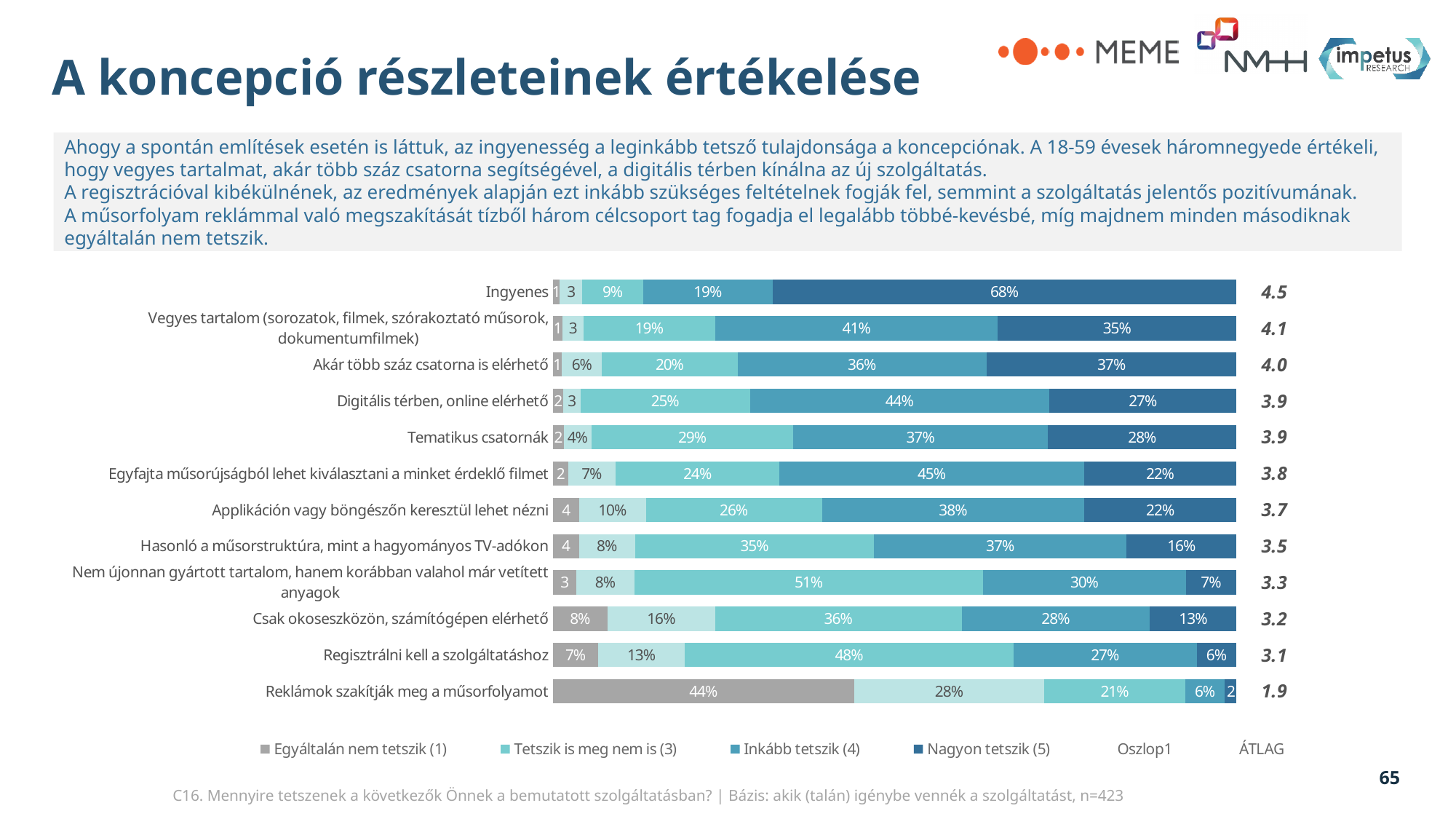
What is the "Egyáltalán nem tetszik (1)" share for "Reklámok szakítják meg a műsorfolyamot"? 44% What is the ÁTLAG value for "Regisztrálni kell a szolgáltatáshoz"? 3.1 What percentage of respondents answered "Nagyon tetszik (5)" for "Ingyenes"? 68% What is the difference in the "Nagyon tetszik (5)" share between "Ingyenes" (68%) and "Vegyes tartalom" (35%)? 33 percentage points Which has a larger "Inkább tetszik (4)" share: "Egyfajta műsorújságból lehet kiválasztani a minket érdeklő filmet" or "Tematikus csatornák"? Egyfajta műsorújságból lehet kiválasztani a minket érdeklő filmet What is the "Tetszik is meg nem is (3)" share for "Nem újonnan gyártott tartalom, hanem korábban valahol már vetített anyagok"? 51% How many items (categories) are shown in the chart? 12 How many entries does the chart legend list? 6 Which item has the highest ÁTLAG value? Ingyenes Do the ÁTLAG values rise or fall going from the top item to the bottom item of the chart? Fall Which item has the lowest ÁTLAG value? Reklámok szakítják meg a műsorfolyamot What type of chart is shown on the slide? Stacked bar chart